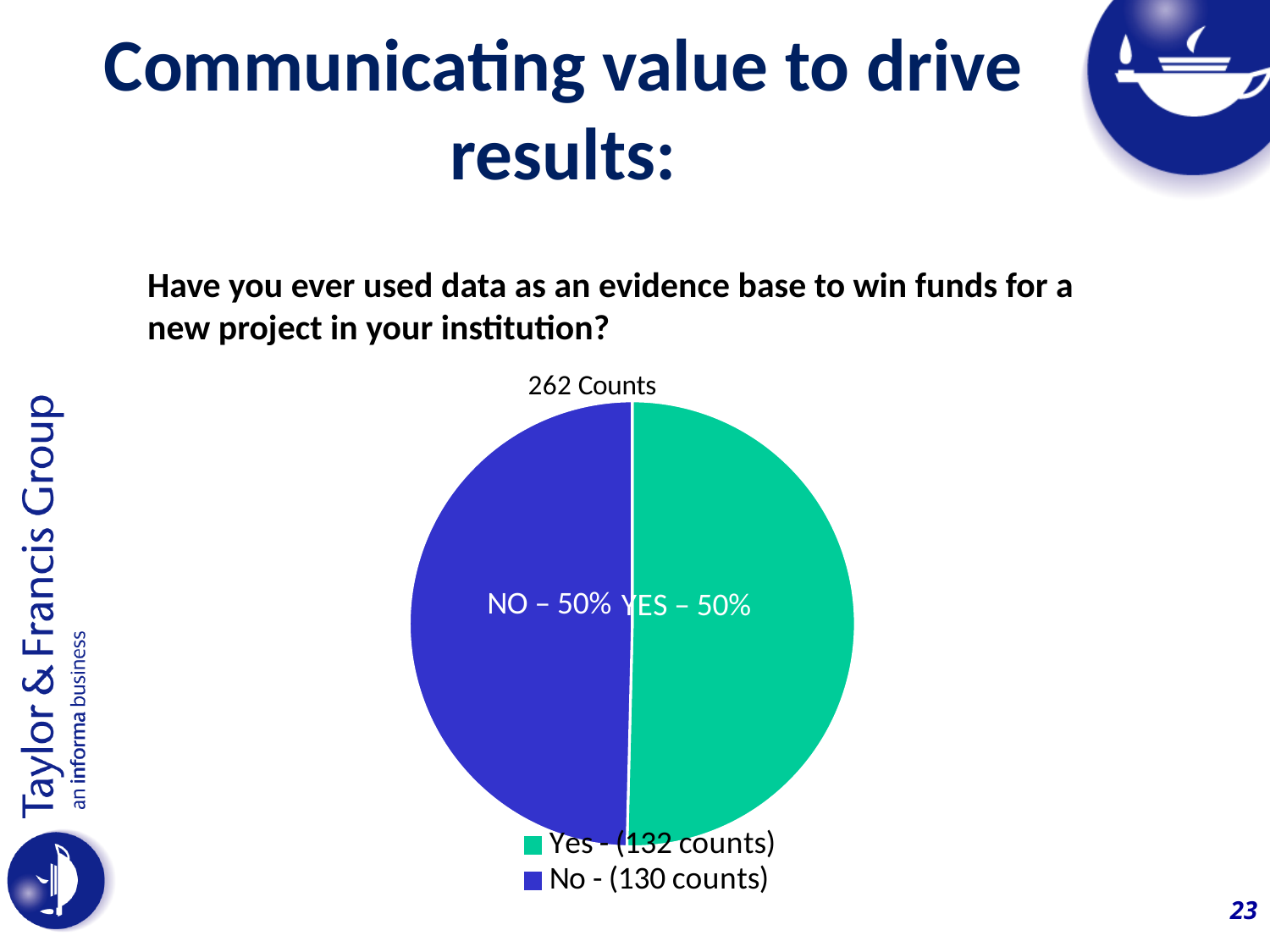
Which colour represents the No slice in the pie chart? blue What share of the pie is labelled for NO? 50% How many entries does the legend of the pie chart list? 2 What is the title of the pie chart? 262 Counts How many counts does the legend give for No? 130 counts What share of the pie is labelled for YES? 50% What kind of chart is shown on the slide? pie chart How many slices does the pie chart have? 2 What is the difference in counts between Yes and No according to the legend? 2 counts What is the total number of counts shown in the chart title? 262 Counts How many counts does the legend give for Yes? 132 counts According to the legend counts, which response has more counts, Yes or No? Yes